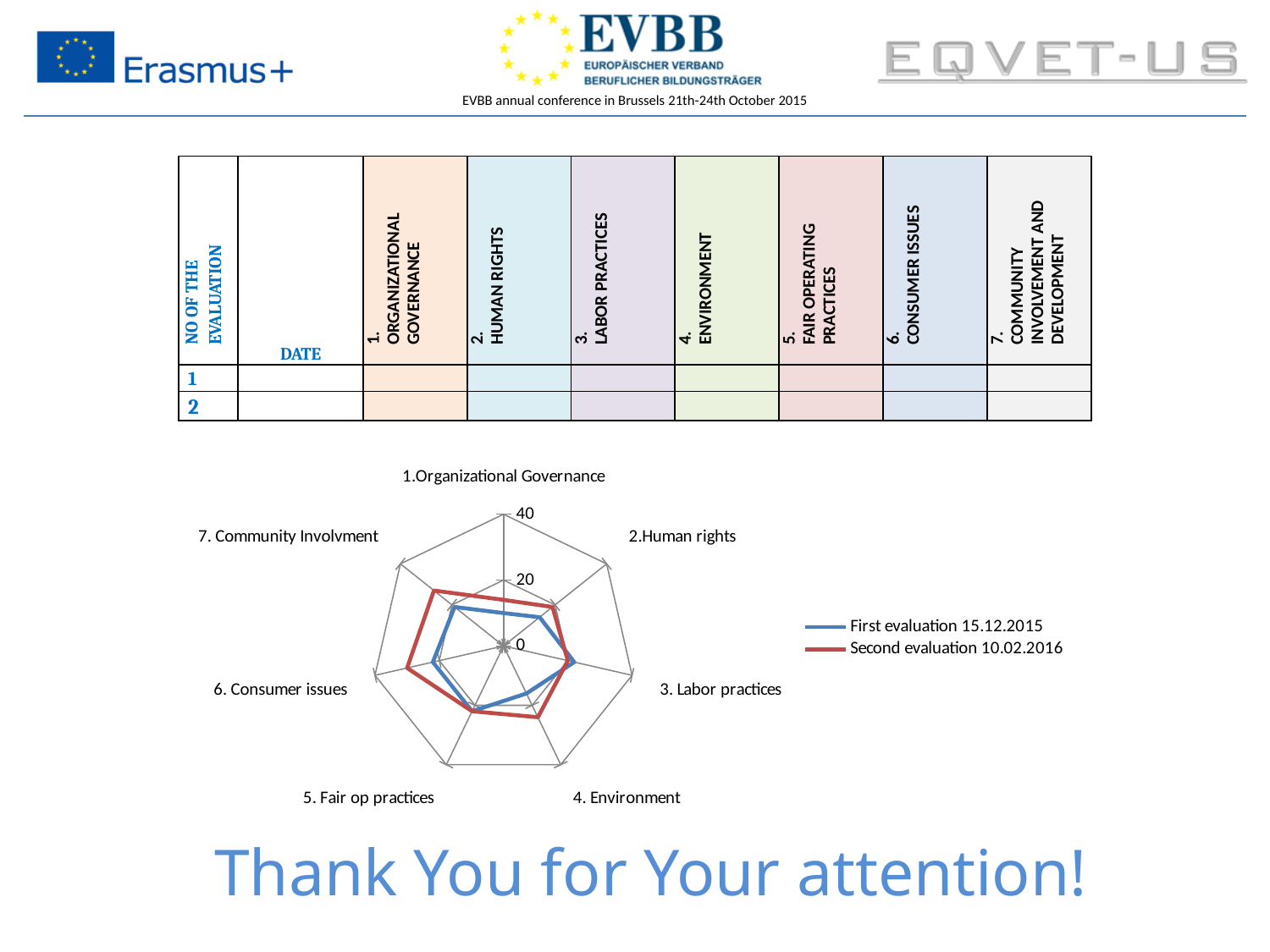
What are the two series named in the legend of the radar chart? First evaluation 15.12.2015 and Second evaluation 10.02.2016 Is the value for 1.Organizational Governance in the First evaluation 15.12.2015 series greater or less than 20? less In the First evaluation 15.12.2015 series, which category has the lowest value? 1.Organizational Governance For 6. Consumer issues, which series has the larger value: First evaluation 15.12.2015 or Second evaluation 10.02.2016? Second evaluation 10.02.2016 For 7. Community Involvment, which series has the larger value: First evaluation 15.12.2015 or Second evaluation 10.02.2016? Second evaluation 10.02.2016 Is the value for 6. Consumer issues in the Second evaluation 10.02.2016 series greater or less than 20? greater How many categories (axes) does the radar chart have? 7 What kind of chart is shown on the slide? radar chart How many series does the legend of the radar chart list? 2 Is the value for 1.Organizational Governance in the Second evaluation 10.02.2016 series greater or less than 20? less Which colour represents the Second evaluation 10.02.2016 series in the radar chart? red In the Second evaluation 10.02.2016 series, which category has the highest value? 6. Consumer issues